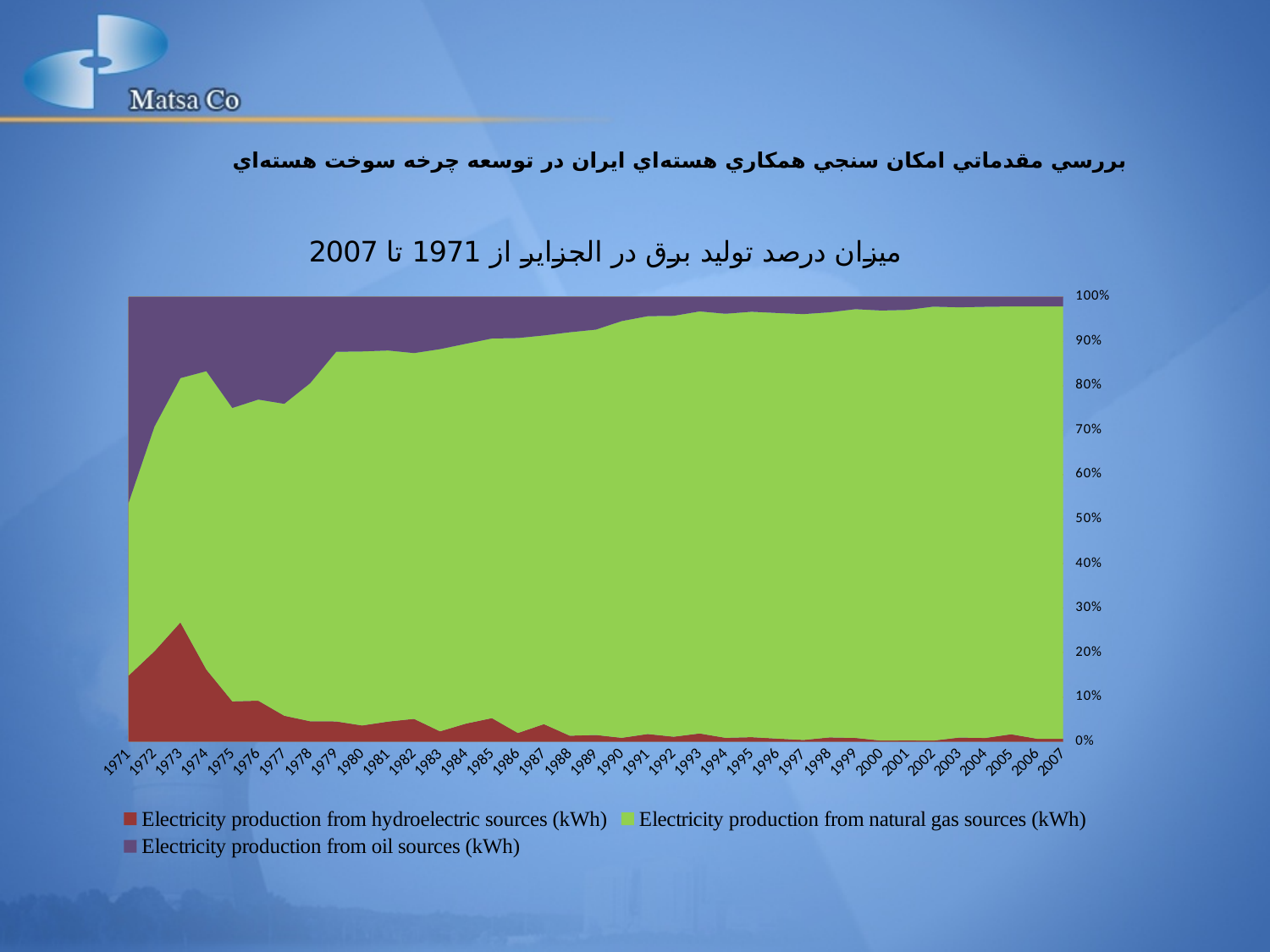
How many series does the legend list? 3 Is the share of electricity production from hydroelectric sources in 1973 greater or less than 20%? greater Is the share of electricity production from hydroelectric sources in 2007 greater or less than 10%? less Does the share of electricity production from natural gas sources rise or fall from 1971 to 2007? Rise In 2007, which series has the larger share: natural gas sources or hydroelectric sources? Natural gas sources What is the last year shown on the x axis? 2007 Is the share of electricity production from oil sources in 2007 greater or less than 10%? less What kind of chart is shown on the slide? Stacked area chart Does the share of electricity production from oil sources rise or fall from 1971 to 2007? Fall How many years are shown along the x axis? 37 What is the first year shown on the x axis? 1971